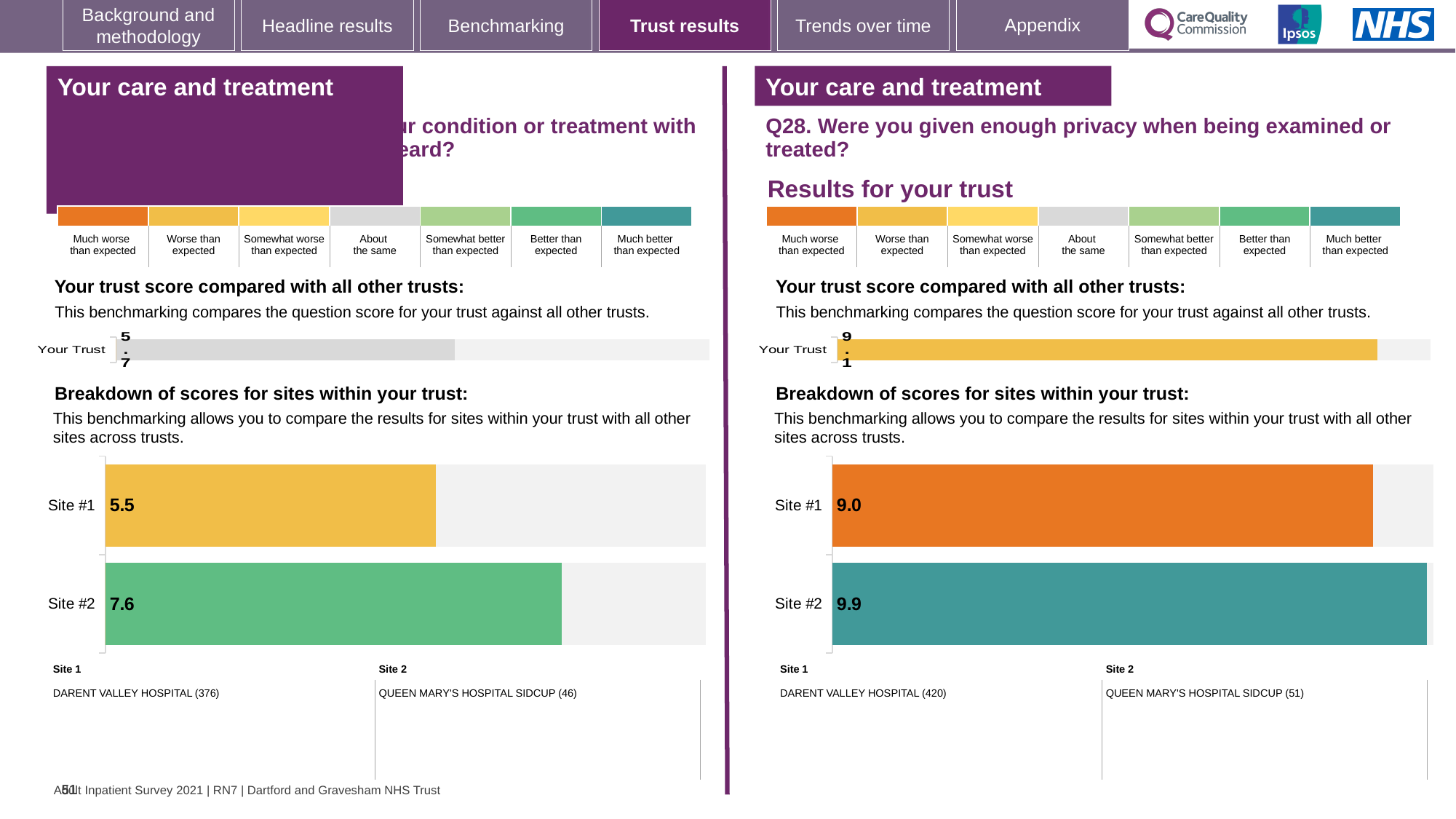
On the right-hand site breakdown chart (Q28), what is the difference between the Site #2 and Site #1 scores? 0.9 On the right-hand site breakdown chart (Q28), which site has the lower score? Site #1 What type of chart is used for the site breakdown on the left-hand side of the slide? Bar chart On the left-hand 'Your trust score compared with all other trusts' chart, what is the score for Your Trust? 5.7 On the left-hand 'Breakdown of scores for sites within your trust' chart, what is the score for Site #1? 5.5 On the left-hand site breakdown chart, which site has the higher score? Site #2 On the left-hand 'Breakdown of scores for sites within your trust' chart, what is the score for Site #2? 7.6 On the right-hand 'Breakdown of scores for sites within your trust' chart (Q28), what is the score for Site #2? 9.9 On the right-hand 'Breakdown of scores for sites within your trust' chart (Q28), what is the score for Site #1? 9.0 On the left-hand site breakdown chart, what is the difference between the Site #2 and Site #1 scores? 2.1 On the right-hand 'Your trust score compared with all other trusts' chart (Q28), what is the score for Your Trust? 9.1 How many sites are shown on the right-hand site breakdown chart (Q28)? 2